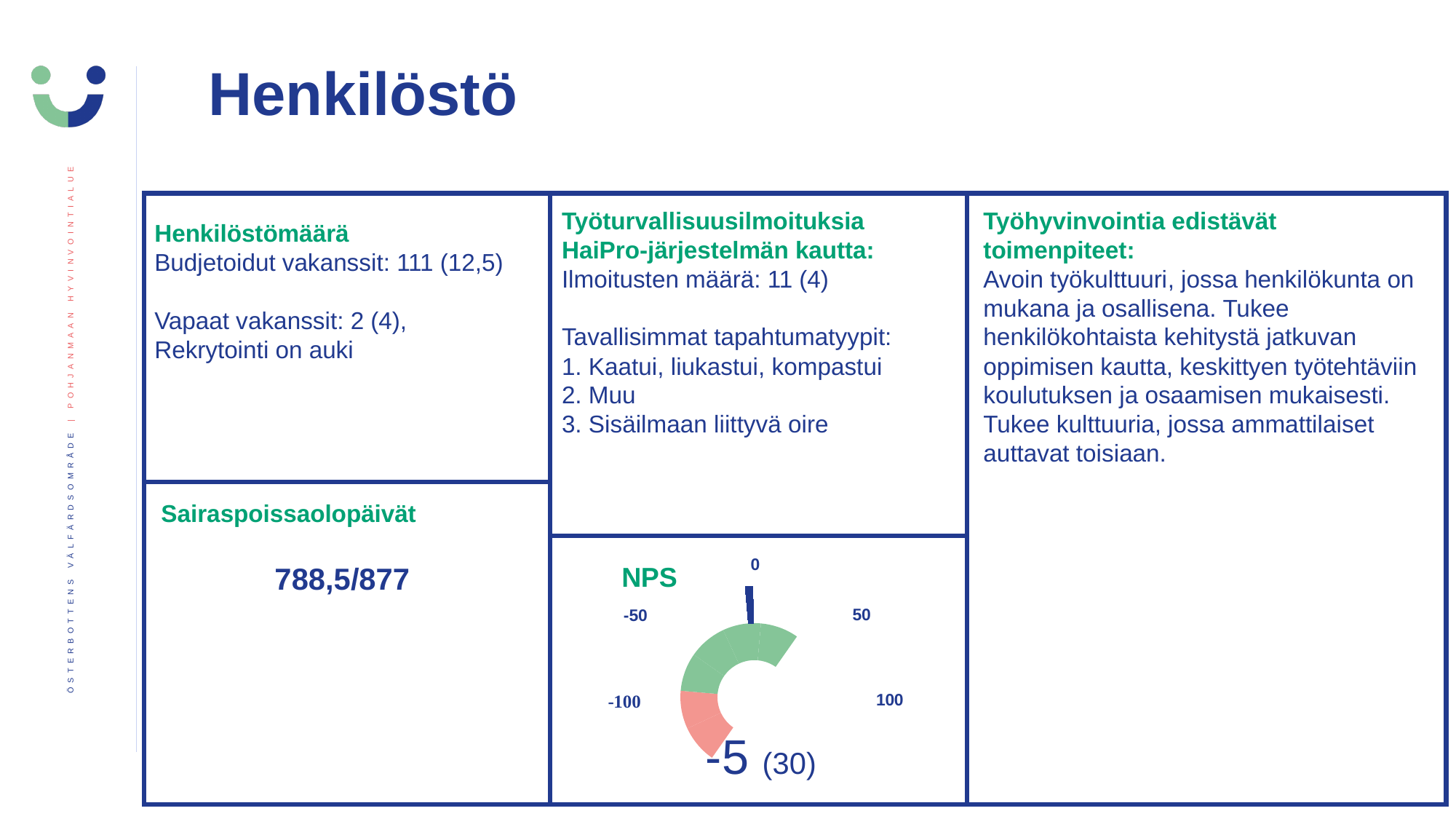
What number is shown in parentheses next to the NPS value on the gauge chart? 30 What is the title of the gauge chart? NPS What NPS value is printed below the gauge chart? -5 What is the lowest tick label on the NPS gauge scale? -100 What kind of chart is shown in the NPS panel? gauge chart How many tick labels are printed around the NPS gauge? 5 Is the NPS value shown on the gauge greater or less than 0? less Is the NPS value shown on the gauge greater or less than -50? greater What two colours are used for the filled segments of the NPS gauge? green and red What is the highest tick label on the NPS gauge scale? 100